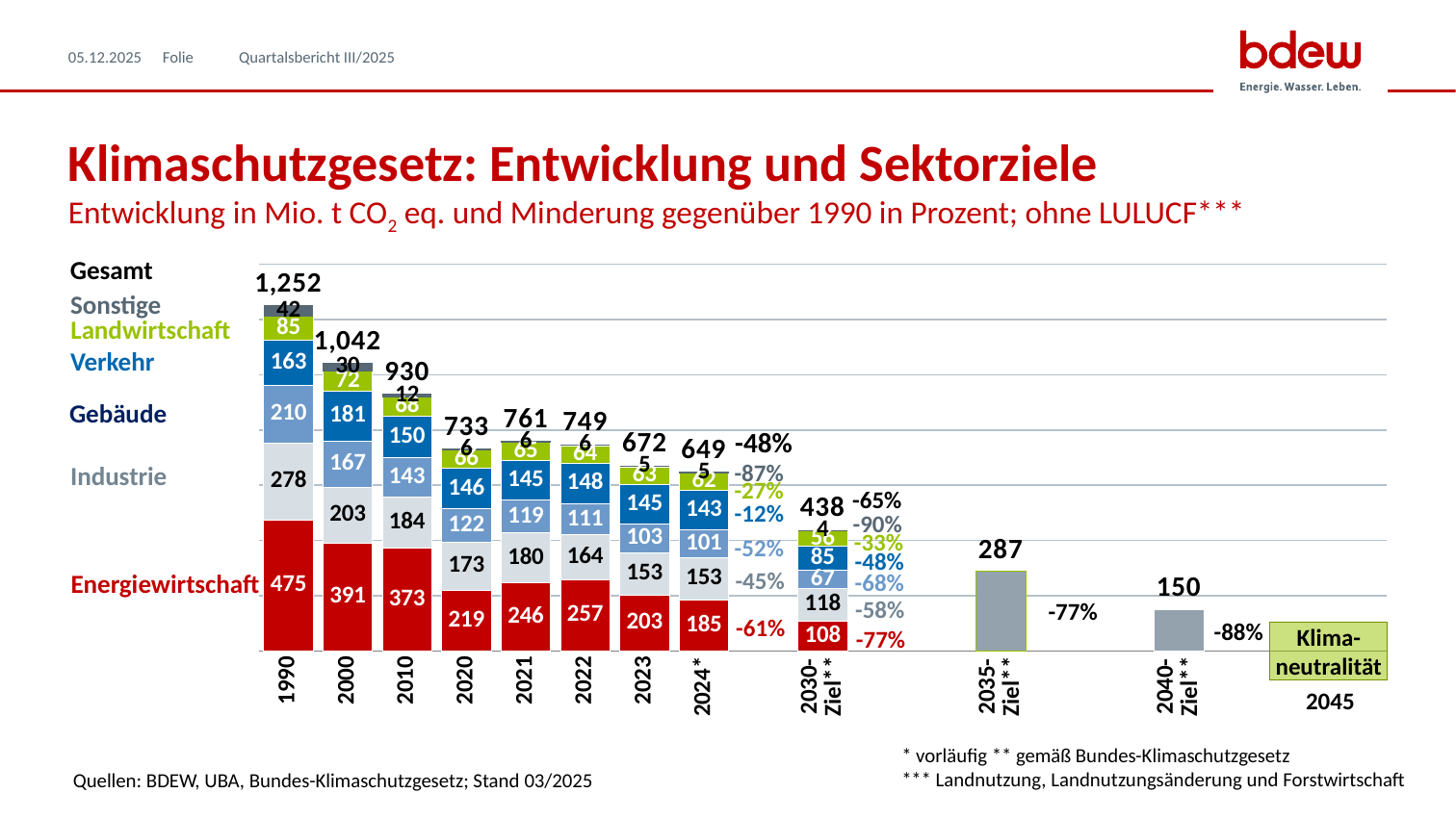
What is the difference between the total for 2021 and the total for 2022? 12 What is the Energiewirtschaft value for 2024*? 185 What percentage reduction versus 1990 is shown for the 2040-Ziel** total? -88% How many sectors are listed in the legend on the left of the chart? 6 Which year has the highest total value? 1990 What kind of chart is shown on the slide? Stacked bar chart What is the Industrie value for 2000? 203 Which sector has the largest value in the 1990 bar? Energiewirtschaft Which is larger, the Verkehr value for 2023 or the Verkehr value for 2030-Ziel**? 2023 What was the total (Gesamt) value for 1990? 1,252 What is the total value shown for the 2035-Ziel** bar? 287 Do the total values generally rise or fall from 1990 to 2040-Ziel**? Fall